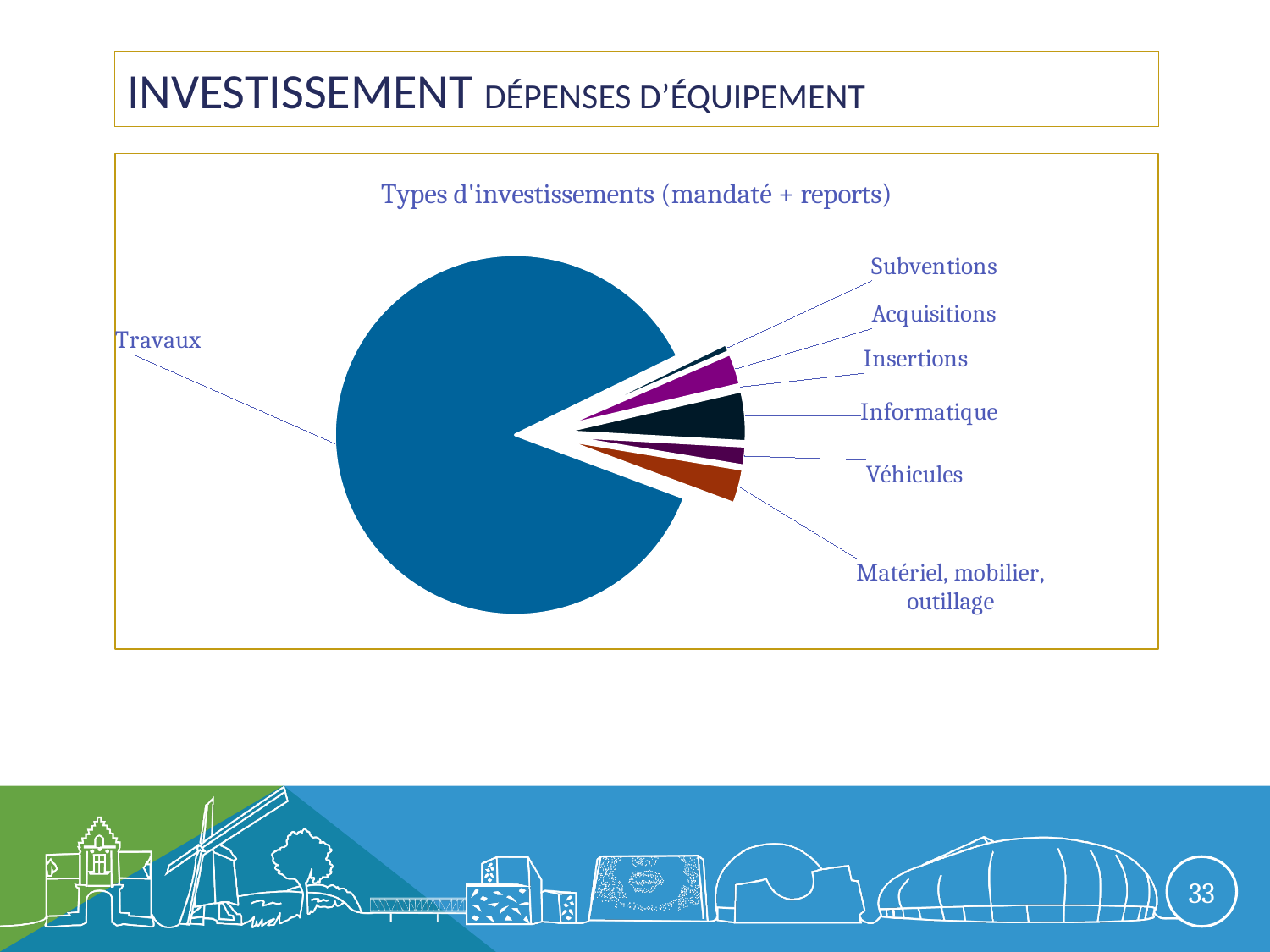
How many slices does the pie chart have? 7 Which slice is larger, Informatique or Subventions? Informatique What is the title of the chart? Types d'investissements (mandaté + reports) What kind of chart is shown on the slide? pie chart Which slice is larger, Matériel, mobilier, outillage or Insertions? Matériel, mobilier, outillage What colour is the Travaux slice? blue Which slice is larger, Travaux or Informatique? Travaux Which category has the largest slice of the pie? Travaux